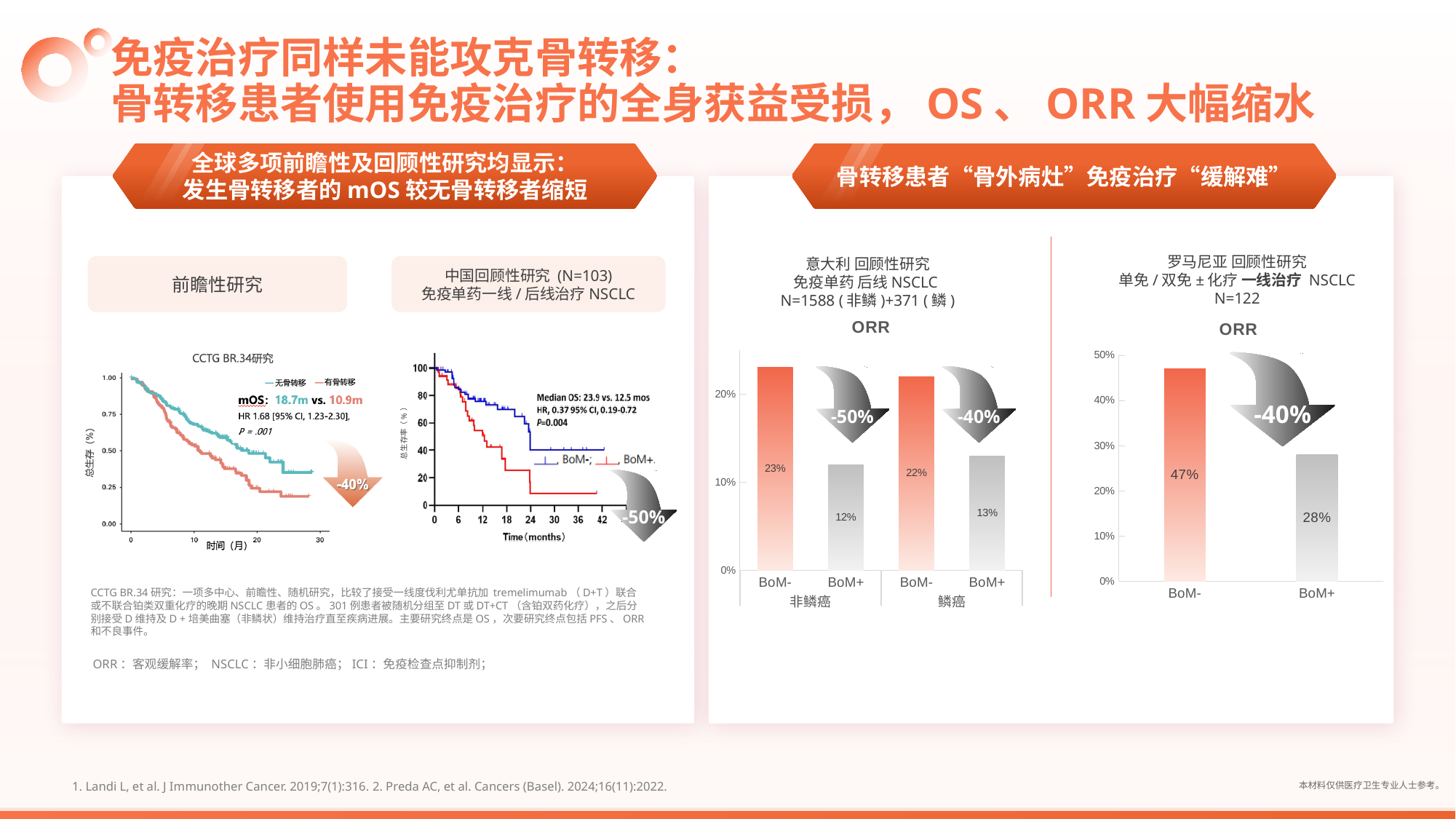
In the Italian retrospective study ORR chart (middle), what is the ORR for BoM+ patients in the squamous (鳞癌) group? 13% In the CCTG BR.34 survival curve chart (left), what is the mOS for patients with bone metastases (有骨转移)? 10.9m In the Italian retrospective study ORR chart (middle), what is the ORR for BoM- patients in the non-squamous (非鳞癌) group? 23% In the Italian retrospective study ORR chart (middle), which bar is the highest? BoM- in 非鳞癌 (23%) How many bars are plotted in the Romanian retrospective study ORR chart (right)? 2 In the Romanian retrospective study ORR chart (right), what is the ORR for BoM+ patients? 28% What kind of chart is the Romanian retrospective study ORR chart (right)? bar chart In the Chinese retrospective study survival curve chart (left), what median OS values are annotated? 23.9 vs. 12.5 mos In the Italian retrospective study ORR chart (middle), what is the difference between the BoM- and BoM+ ORR in the non-squamous (非鳞癌) group? 11% In the Italian retrospective study ORR chart (middle), which is larger: the BoM+ ORR in 非鳞癌 or the BoM+ ORR in 鳞癌? BoM+ in 鳞癌 (13%) In the Romanian retrospective study ORR chart (right), what is the difference between the BoM- and BoM+ ORR? 19% In the Romanian retrospective study ORR chart (right), is the value for BoM- greater or less than 40%? greater